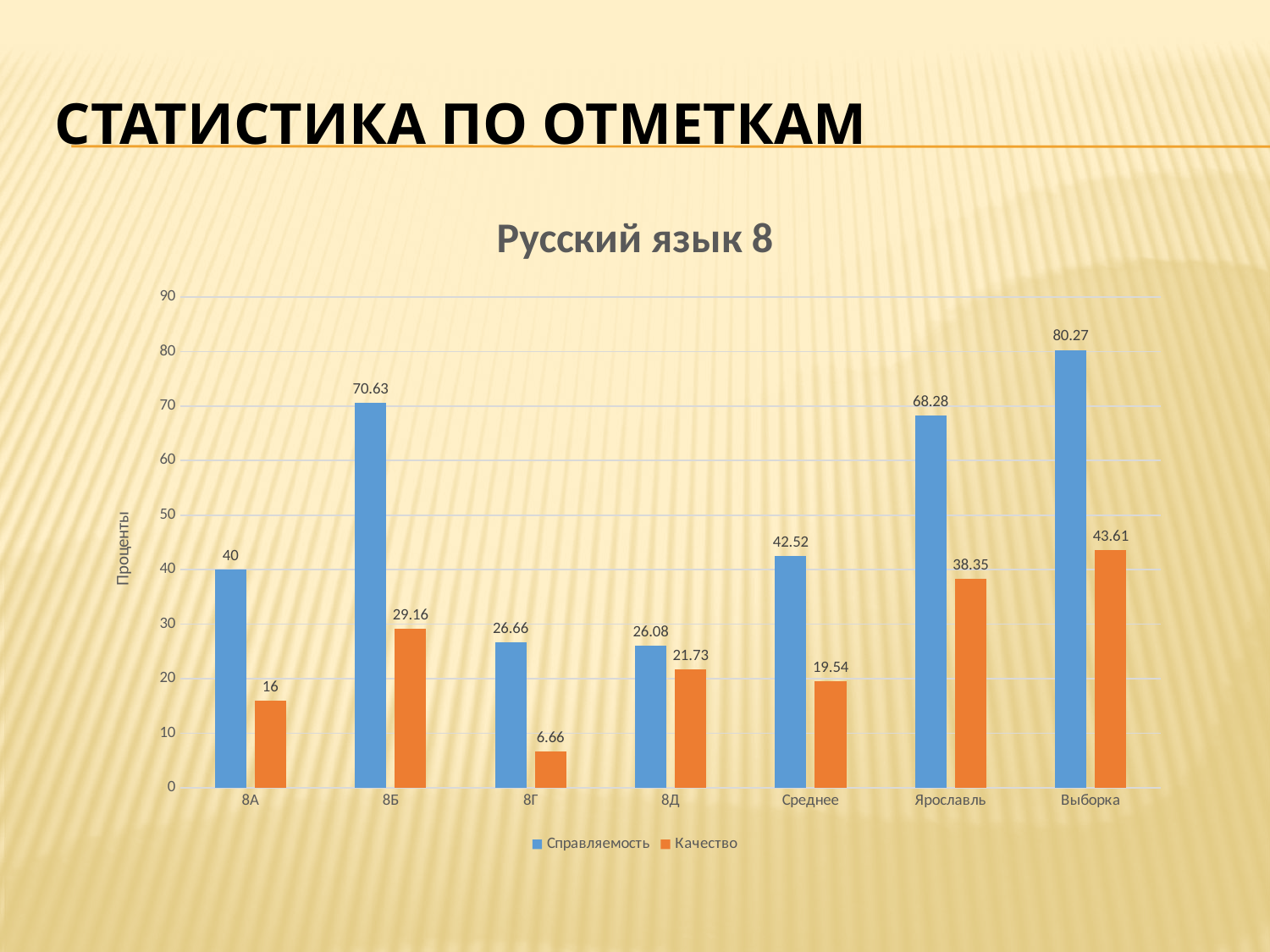
Which category has the highest Справляемость value? Выборка What is the Качество value for Ярославль? 38.35 What is the Качество value for 8Г? 6.66 What is the difference between the Справляемость values for Выборка and Ярославль? 11.99 Is the Справляемость value for Среднее greater or less than 40? greater What type of chart is shown? bar chart Which category has the lowest Качество value? 8Г Which is larger: the Качество value for 8Б or for 8Д? 8Б How many series does the legend list? 2 What is the Справляемость value for 8Б? 70.63 How many categories are shown on the x axis? 7 What is the difference between the Справляемость and Качество values for 8А? 24